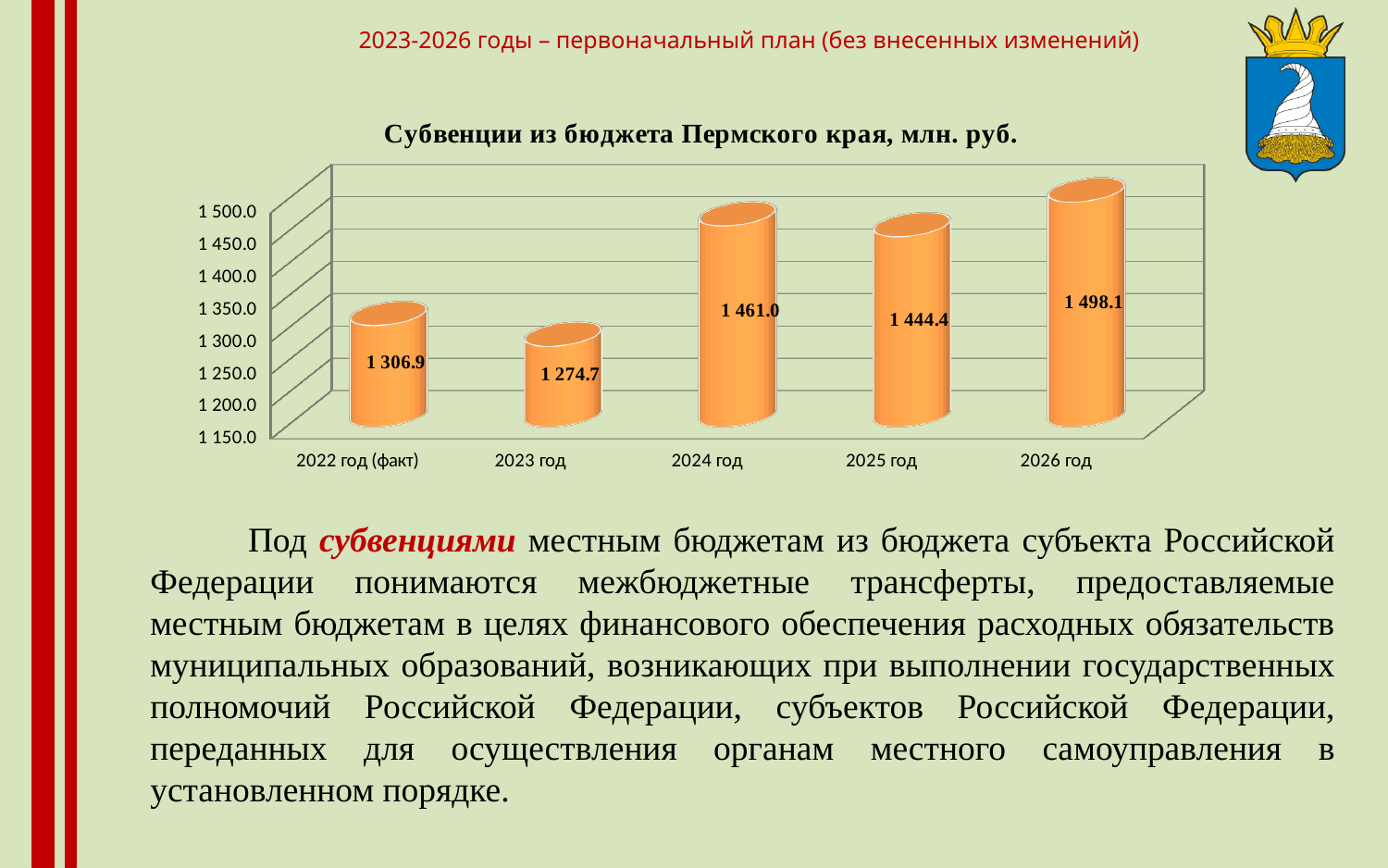
What is the value for 2022 год (факт)? 1 306.9 What is the value for 2024 год in the chart "Субвенции из бюджета Пермского края, млн. руб."? 1 461.0 Which year has the lowest value in the chart? 2023 год What is the title of the chart? Субвенции из бюджета Пермского края, млн. руб. What is the difference between the values for 2026 год and 2023 год? 223.4 Which is larger, the value for 2022 год (факт) or the value for 2023 год? 2022 год (факт) What is the difference between the values for 2024 год and 2025 год? 16.6 What is the value for 2025 год? 1 444.4 Which year has the highest value in the chart? 2026 год What kind of chart is shown on the slide? bar chart How many years are shown on the x axis of the chart? 5 Is the value for 2025 год greater or less than 1 400.0? greater